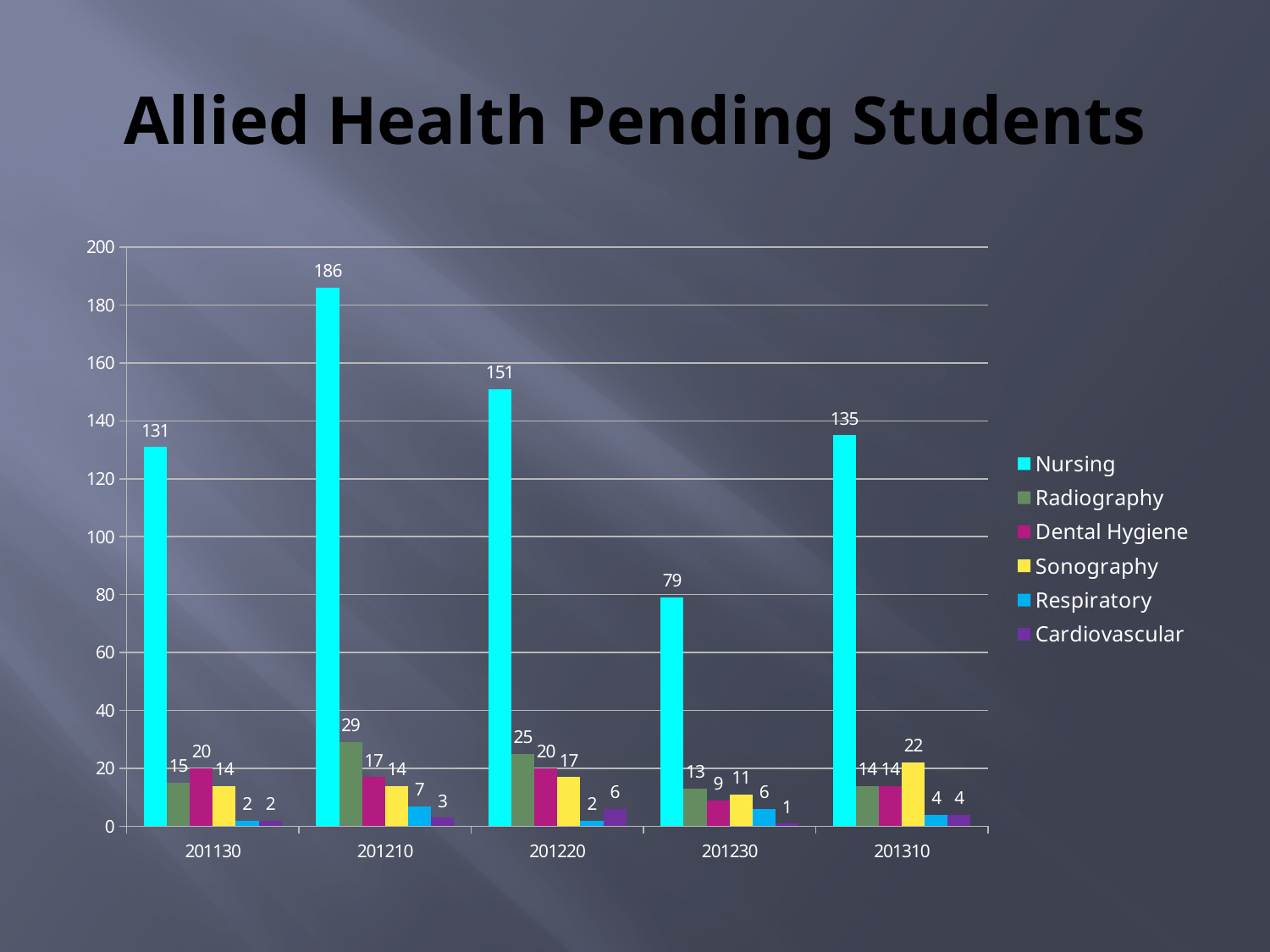
Which is larger, the Dental Hygiene value for 201130 or the Dental Hygiene value for 201230? 201130 How many terms are shown on the x axis? 5 What is the Radiography value for 201220? 25 How many series does the legend list? 6 Which term has the lowest Nursing value? 201230 What is the Sonography value for 201310? 22 Is the Nursing value for 201220 greater or less than 140? greater Which term has the highest Nursing value? 201210 What is the Nursing value for 201210? 186 What kind of chart is shown on the slide? Bar chart What is the title of the chart? Allied Health Pending Students What is the difference between the Nursing values for 201210 and 201230? 107